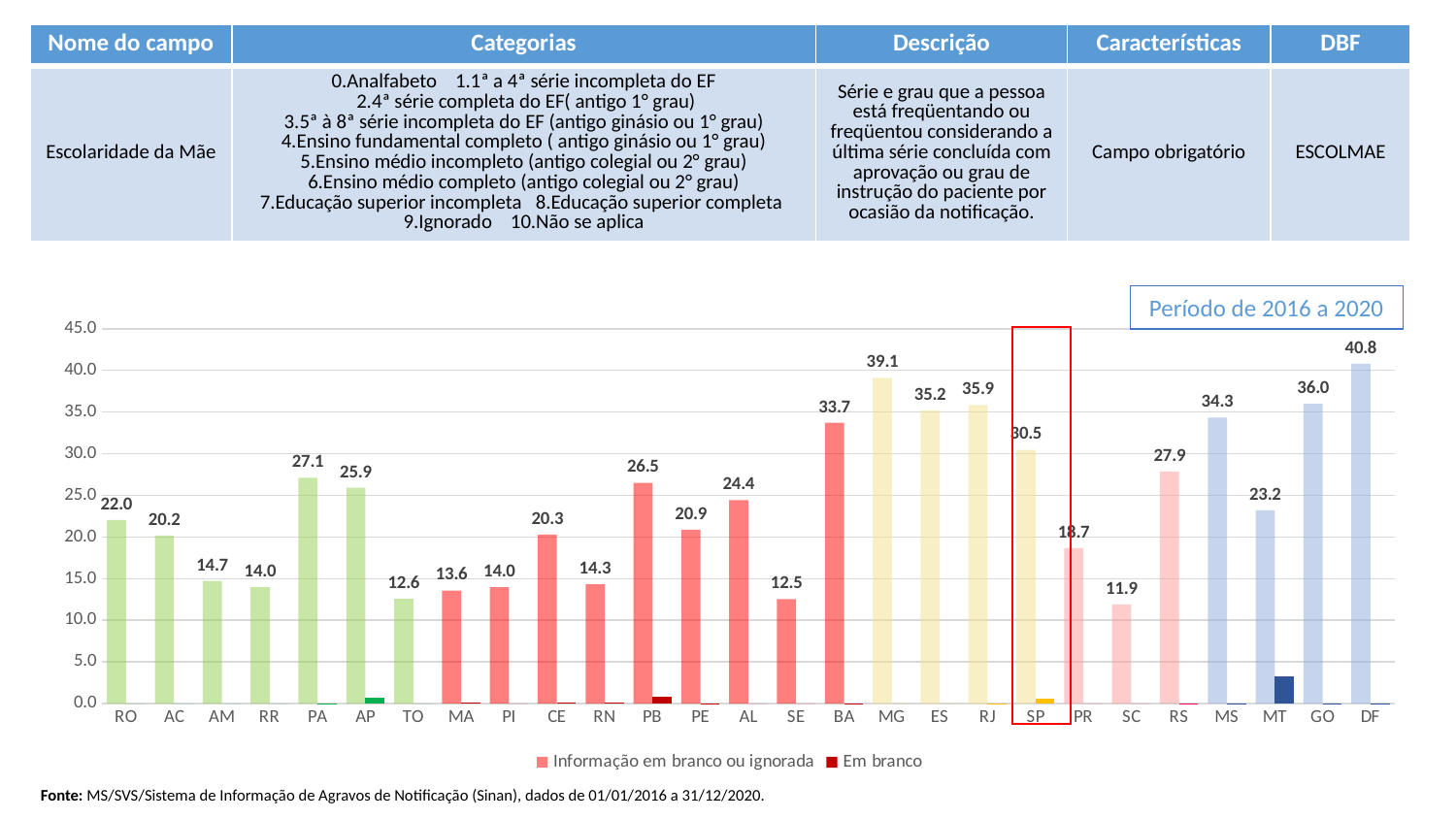
Is the value for BA for 'Informação em branco ou ignorada' greater or less than 30.0? greater What is the value for DF for 'Informação em branco ou ignorada'? 40.8 How many states are shown on the x axis of the chart? 27 What is the value for SP for 'Informação em branco ou ignorada'? 30.5 What is the value for MG for 'Informação em branco ou ignorada'? 39.1 How many series does the legend list? 2 What period does the chart cover, according to the label in the top right? Período de 2016 a 2020 What is the difference between the values for MG and ES for 'Informação em branco ou ignorada'? 3.9 Which state has the highest value for 'Informação em branco ou ignorada'? DF Which state has the lowest value for 'Informação em branco ou ignorada'? SC Which has a larger value for 'Informação em branco ou ignorada', PA or AP? PA What kind of chart is shown on the slide? Bar chart